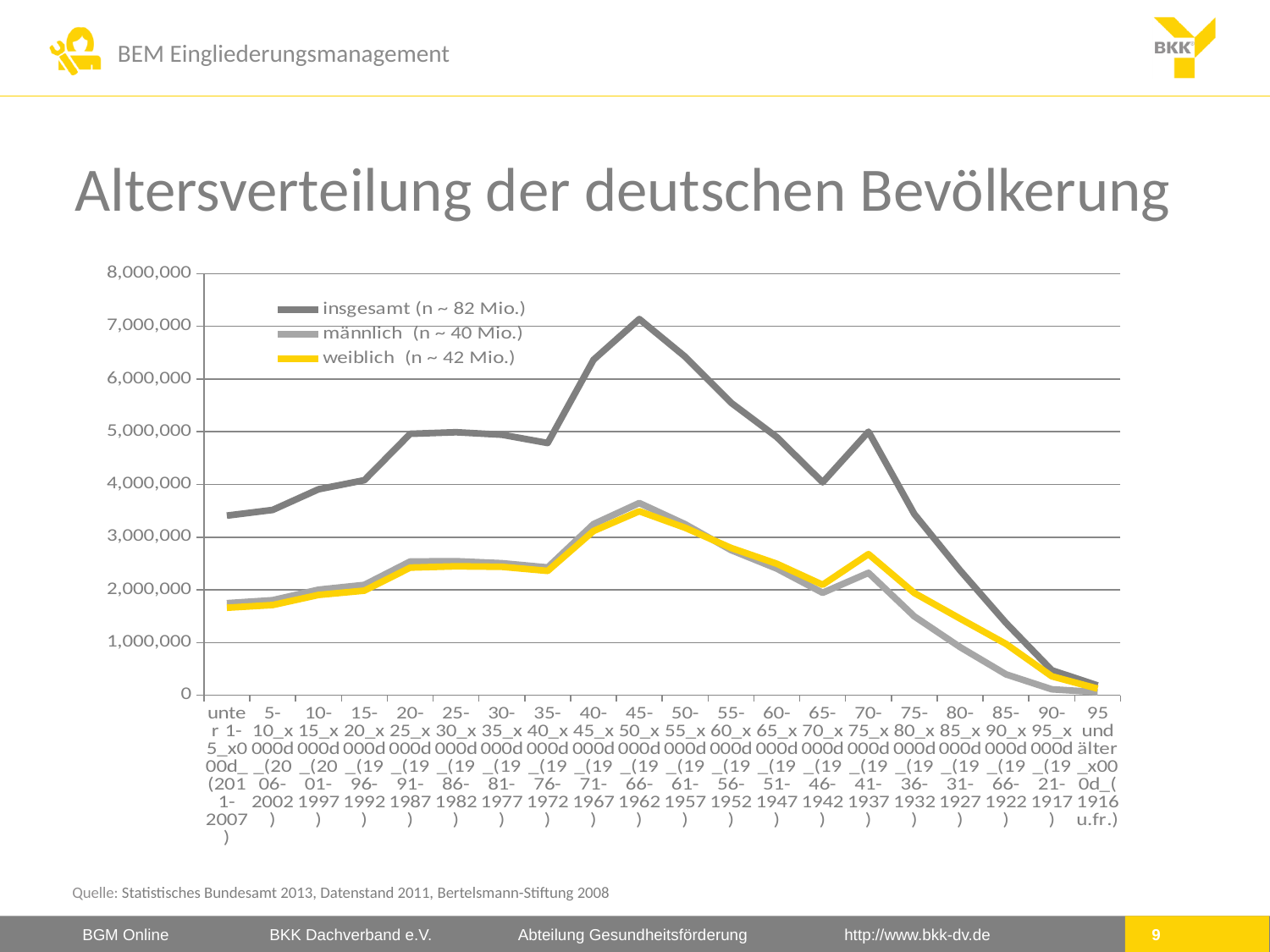
What is the title of the chart? Altersverteilung der deutschen Bevölkerung In which age group does the 'insgesamt' series reach its highest value? 45-50 How many series does the legend list? 3 For the 85-90 age group, which is larger: 'männlich' or 'weiblich'? weiblich Is the value of 'insgesamt' for the 45-50 age group greater or less than 6,000,000? greater What kind of chart is shown on the slide? line chart In which age group does the 'insgesamt' series have its lowest value? 95 und älter Which series is drawn in yellow? weiblich (n ~ 42 Mio.) How many age-group categories are plotted along the x axis? 20 Is the value of 'weiblich' for the 70-75 age group greater or less than 2,000,000? greater Is the value of 'insgesamt' for the 95 und älter age group greater or less than 1,000,000? less Does the 'insgesamt' series rise or fall between the 45-50 and 65-70 age groups? fall